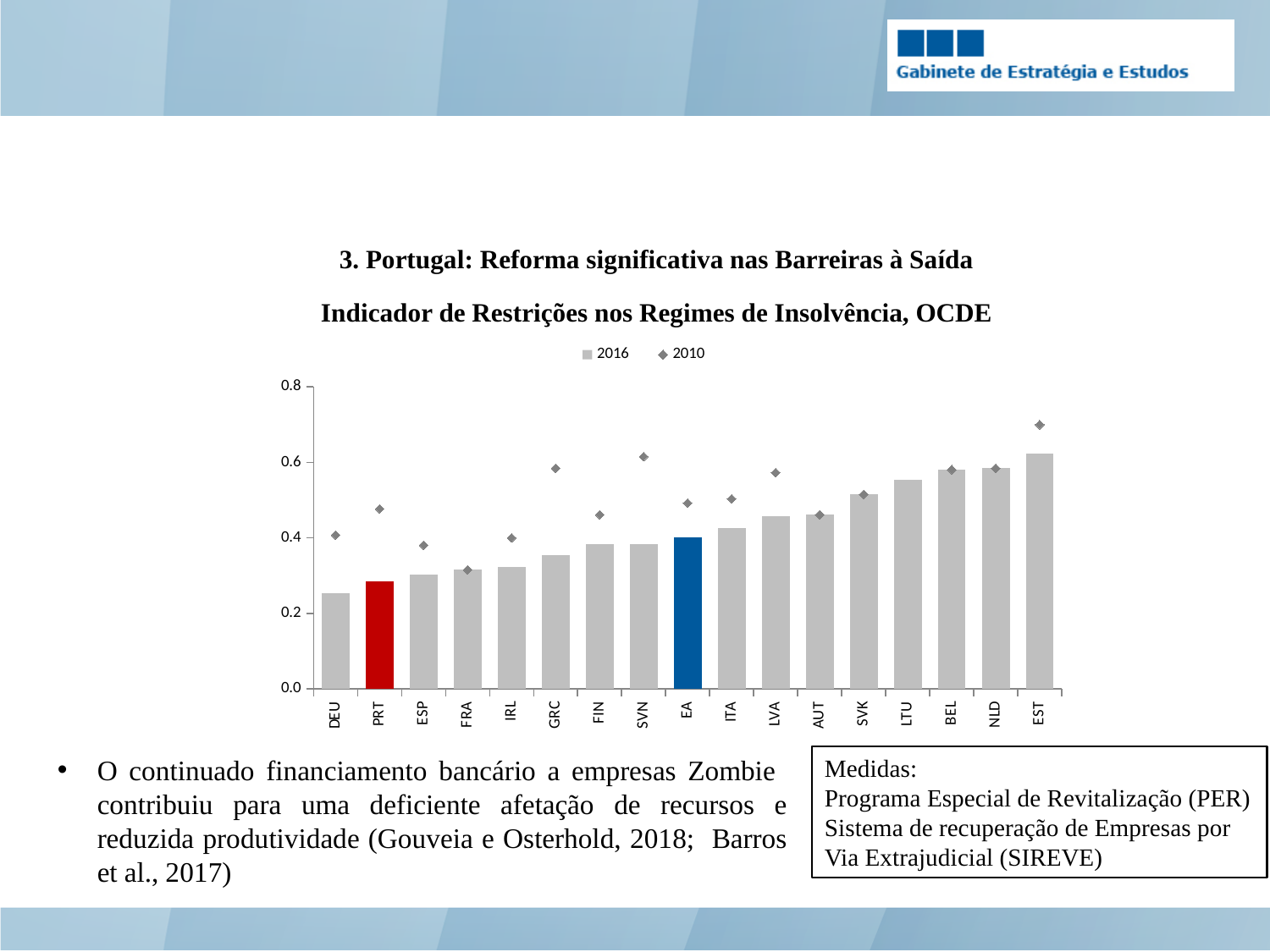
Is the 2010 value for EST greater or less than 0.6? greater Which series are listed in the chart legend? 2016 and 2010 Which category has the lowest 2016 bar? DEU Is the 2016 value for DEU greater or less than 0.4? less For PRT, which is larger: the 2016 value or the 2010 value? 2010 Do the 2016 bars rise or fall from left to right along the x axis? rise What kind of chart is shown on the slide? bar chart Is the 2016 value for PRT greater or less than 0.4? less What colour is the bar for PRT? red How many countries or regions are shown on the x axis of the chart? 17 Which category has the highest 2016 bar? EST How many series does the chart legend list? 2